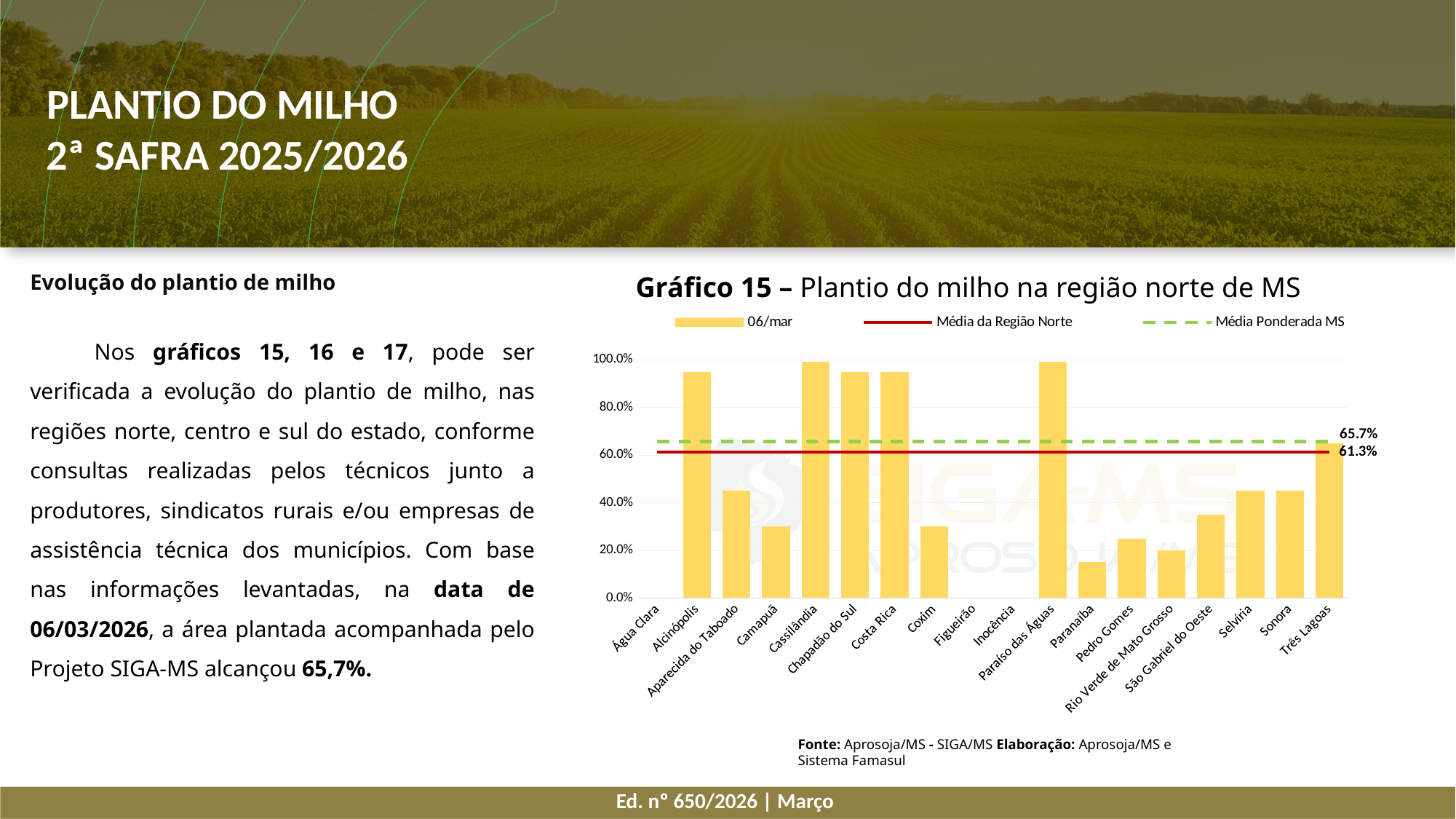
In Gráfico 15, what is the difference between the Média Ponderada MS (65.7%) and the Média da Região Norte (61.3%)? 4.4% In Gráfico 15, is the value for Alcinópolis greater or less than 80.0%? greater In Gráfico 15, what value is labelled for the Média Ponderada MS line? 65.7% In Gráfico 15, is the value for Camapuã greater or less than 40.0%? less How many municipalities are listed on the x axis of Gráfico 15? 18 In Gráfico 15, what colour are the 06/mar bars? yellow In Gráfico 15, which has the larger value: Cassilândia or Coxim? Cassilândia In Gráfico 15, what value is labelled for the Média da Região Norte line? 61.3% In Gráfico 15, which is higher: the Média Ponderada MS or the Média da Região Norte? Média Ponderada MS How many series does the legend of Gráfico 15 list? 3 In Gráfico 15, is the value for Paranaíba greater or less than 20.0%? less What kind of chart is Gráfico 15? bar chart